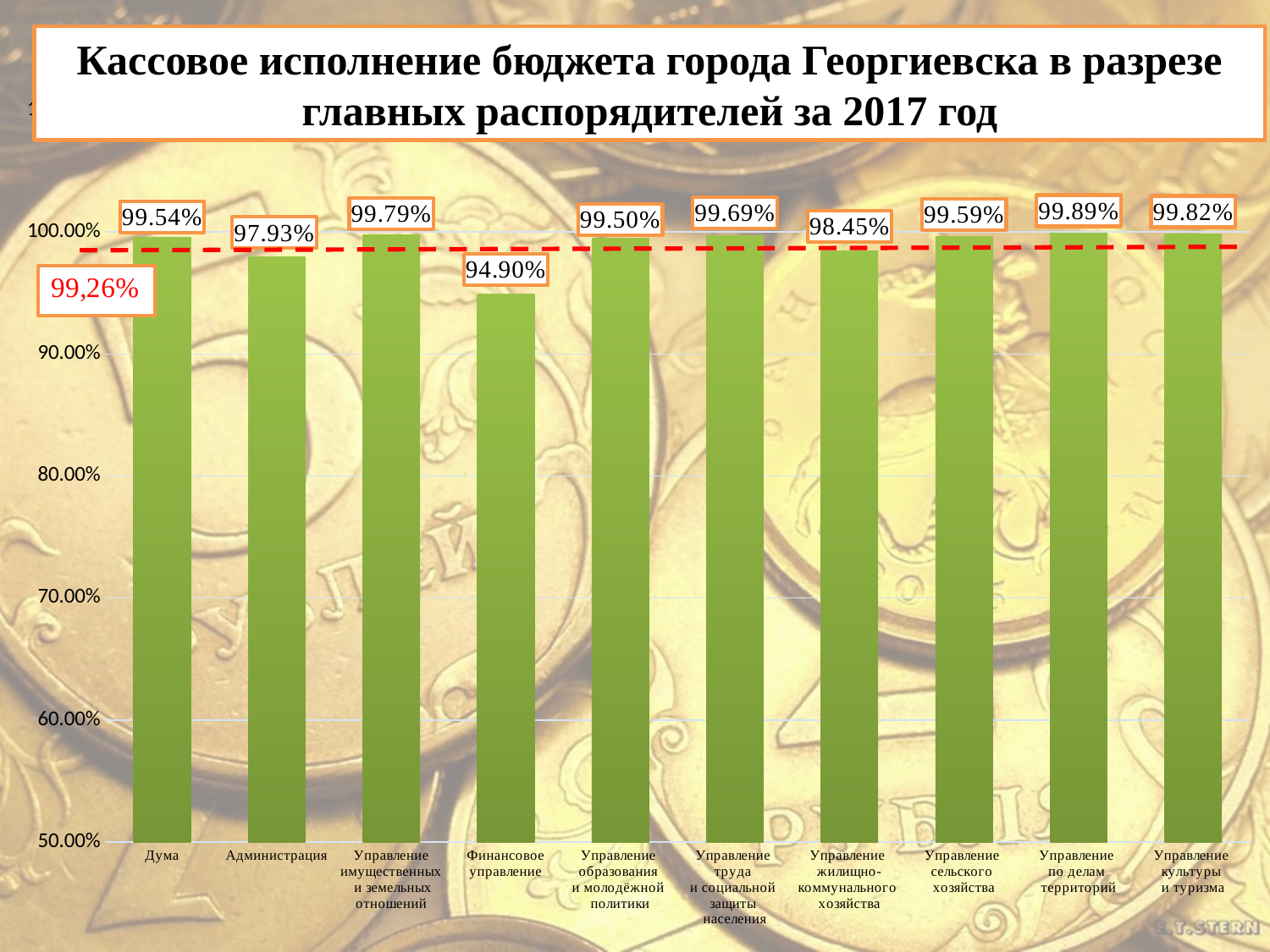
What is the value for Управление культуры и туризма? 99.82% What is the difference between the values for Дума and Администрация? 1.61 percentage points Which is larger: the value for Администрация or the value for Управление сельского хозяйства? Управление сельского хозяйства What is the value for Управление жилищно-коммунального хозяйства? 98.45% How many categories are shown on the chart? 10 What is the value for Дума? 99.54% Which category has the lowest value? Финансовое управление What is the difference between the highest value (Управление по делам территорий) and the lowest value (Финансовое управление)? 4.99 percentage points What is the value for Финансовое управление? 94.90% What value is marked by the red dashed line on the chart? 99,26% What kind of chart is shown on the slide? Bar chart Which category has the highest value? Управление по делам территорий